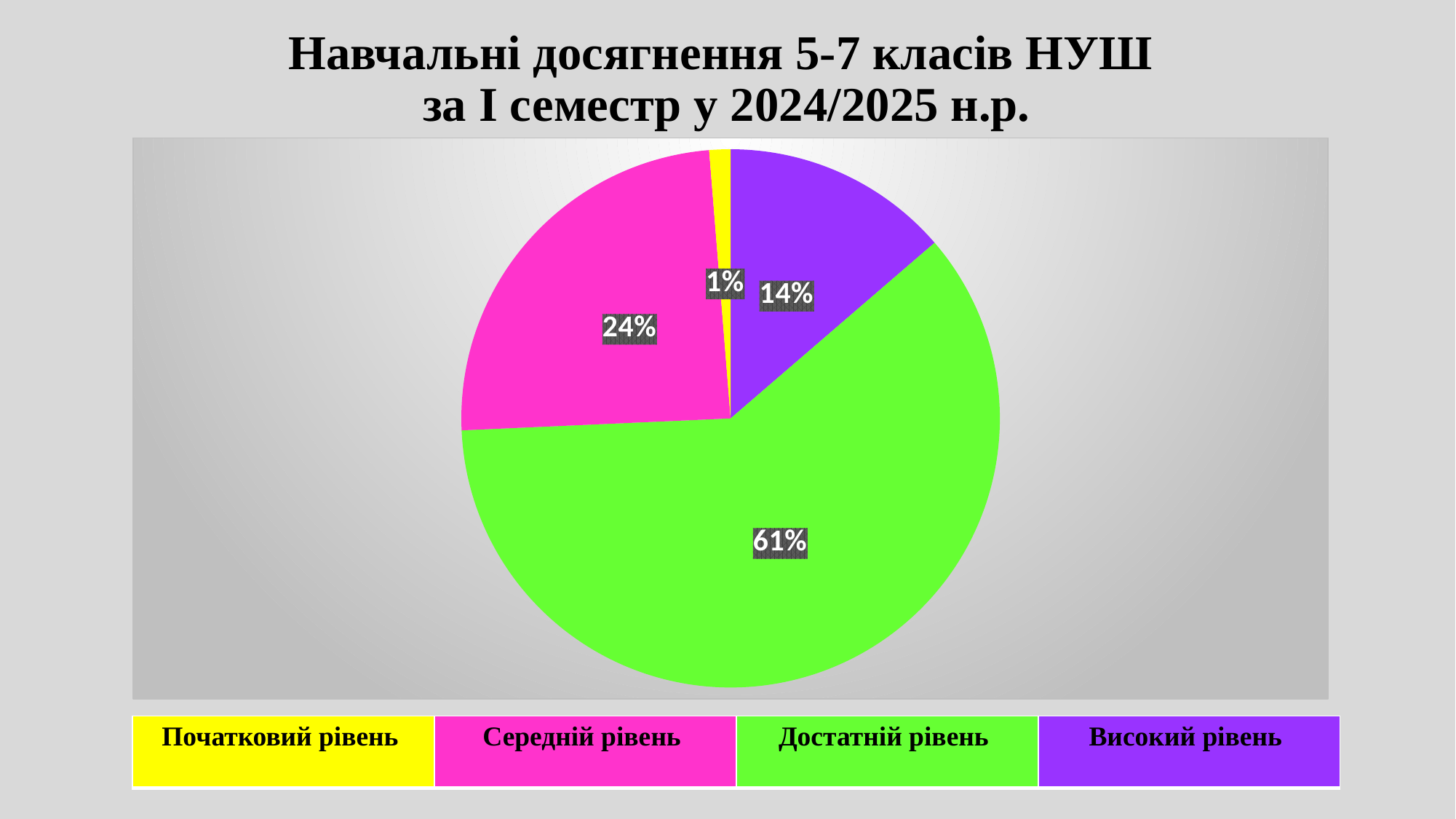
What kind of chart is shown on the slide? pie chart What is the title of the chart? Навчальні досягнення 5-7 класів НУШ за І семестр у 2024/2025 н.р. What is the difference in percentage points between Достатній рівень and Середній рівень? 37 What colour is the slice for Високий рівень? purple How many slices does the pie chart have? 4 What share of the pie is labelled for Високий рівень? 14% Which is larger, the share for Середній рівень or the share for Високий рівень? Середній рівень What share of the pie is labelled for Середній рівень? 24% What share of the pie is labelled for Достатній рівень? 61% Which level has the largest slice of the pie? Достатній рівень Which level has the smallest slice of the pie? Початковий рівень